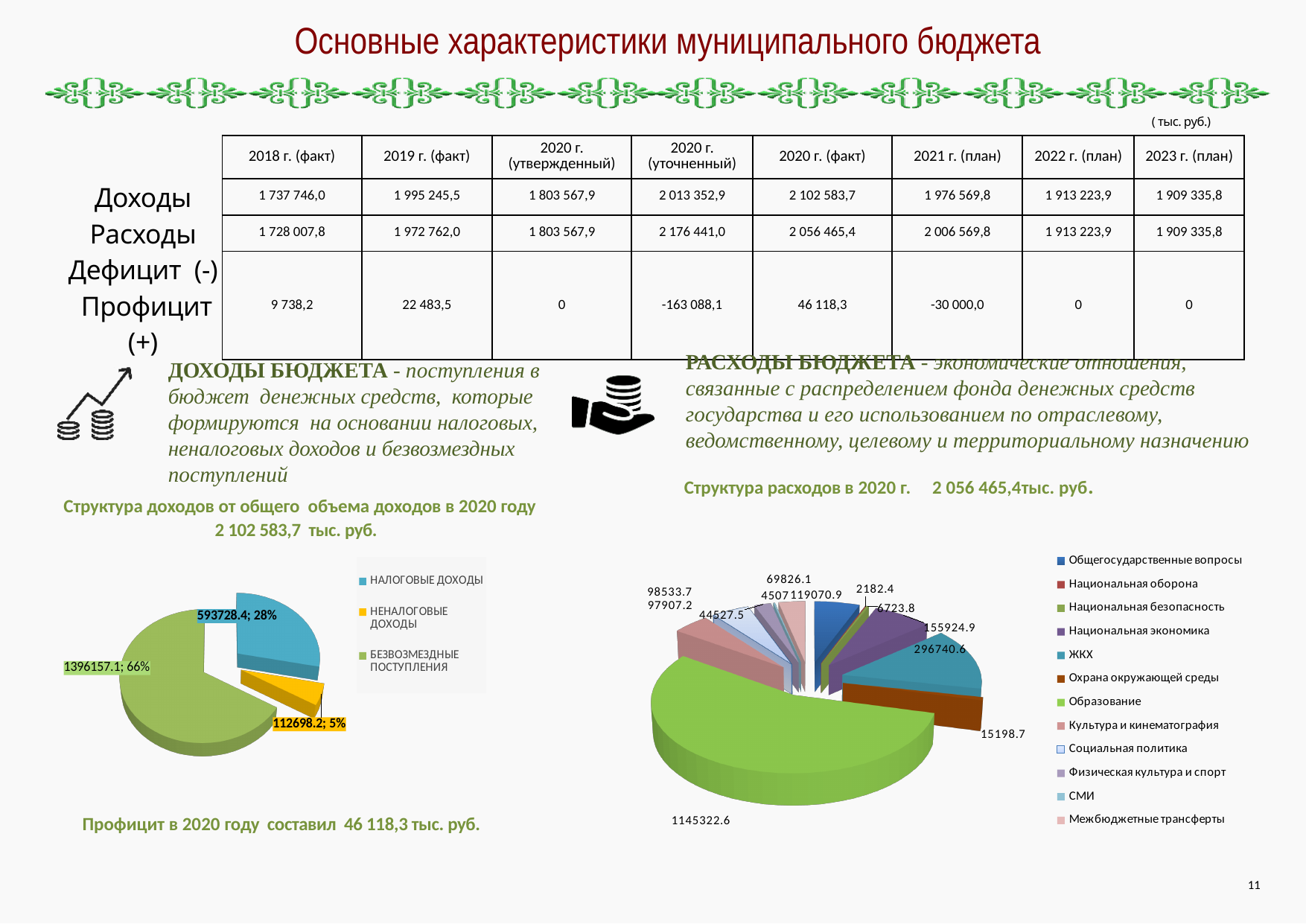
In the right chart (Структура расходов в 2020 г.), what is the value for Образование? 1145322.6 In the right chart (Структура расходов в 2020 г.), what is the value for Охрана окружающей среды? 15198.7 In the right chart (Структура расходов в 2020 г.), which category has the largest slice? Образование In the right chart (Структура расходов в 2020 г.), which is larger: ЖКХ or Национальная экономика? ЖКХ In the left chart (Структура доходов), which category has the smallest slice? НЕНАЛОГОВЫЕ ДОХОДЫ In the left chart (Структура доходов), what is the value for НАЛОГОВЫЕ ДОХОДЫ? 593728.4 How many entries does the legend of the right chart (Структура расходов в 2020 г.) list? 12 In the left chart (Структура доходов), what is the difference between БЕЗВОЗМЕЗДНЫЕ ПОСТУПЛЕНИЯ and НАЛОГОВЫЕ ДОХОДЫ? 802428.7 How many slices does the left chart (Структура доходов) have? 3 In the left chart (Структура доходов), what share of the pie is НЕНАЛОГОВЫЕ ДОХОДЫ? 5% What kind of chart is the left chart (Структура доходов от общего объема доходов в 2020 году)? pie chart In the left chart (Структура доходов), which category has the largest slice? БЕЗВОЗМЕЗДНЫЕ ПОСТУПЛЕНИЯ